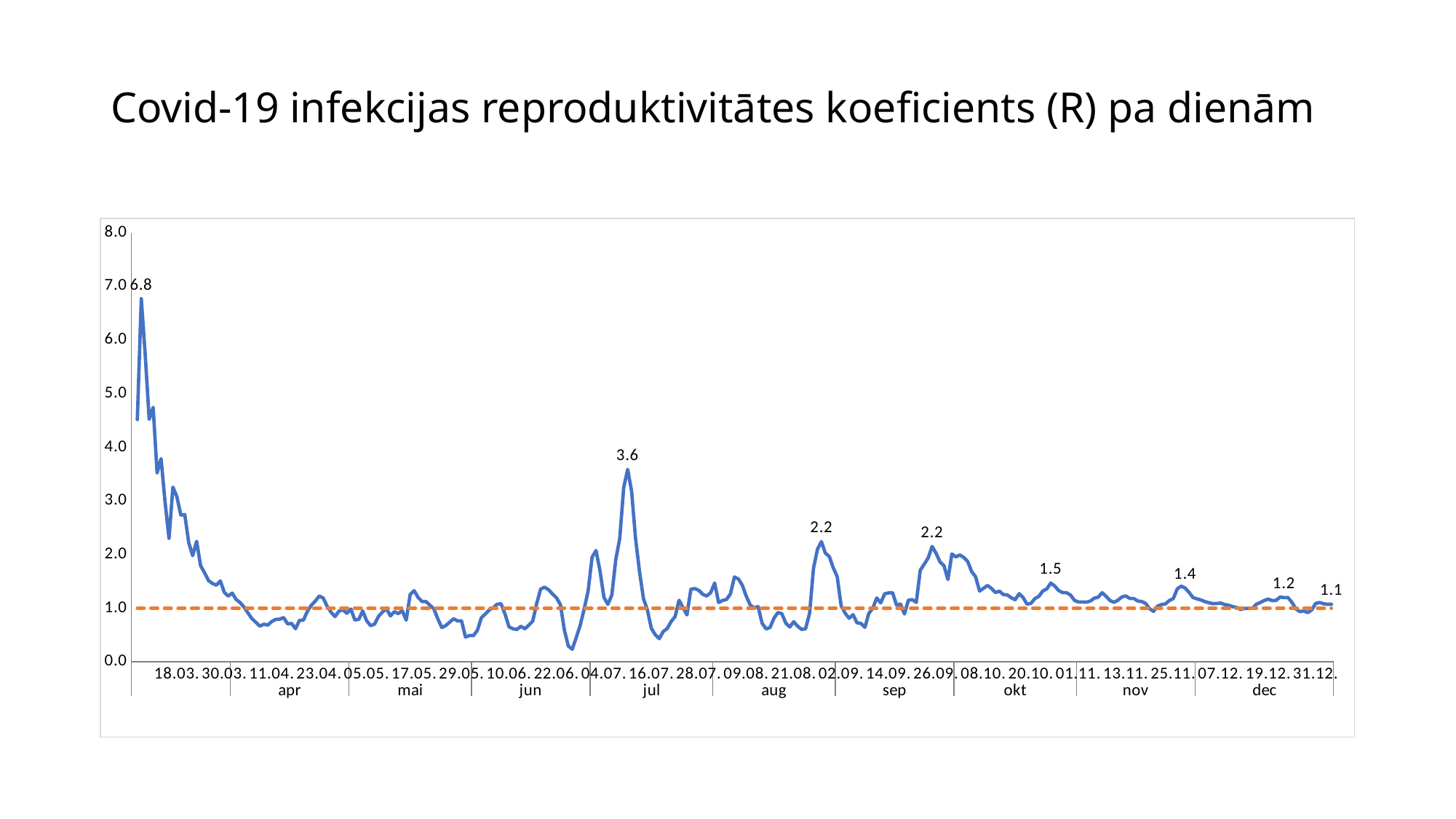
What kind of chart is shown on the slide? line chart What is the difference between the March peak (6.8) and the July peak (3.6)? 3.2 What is the labelled peak value in July (jul)? 3.6 What is the labelled peak value in October (okt)? 1.5 What is the labelled peak value in November (nov)? 1.4 What is the highest labelled value on the chart? 6.8 Which labelled peak is larger: the one in July or the one in September (sep)? July (3.6) Overall, does the R value rise or fall from March to December? fall At what level is the dashed orange horizontal reference line drawn? 1.0 Is the lowest point of the line in late June greater or less than 1.0? less What is the title of the chart? Covid-19 infekcijas reproduktivitātes koeficients (R) pa dienām What is the last labelled value at the right end of the line, at the end of December? 1.1